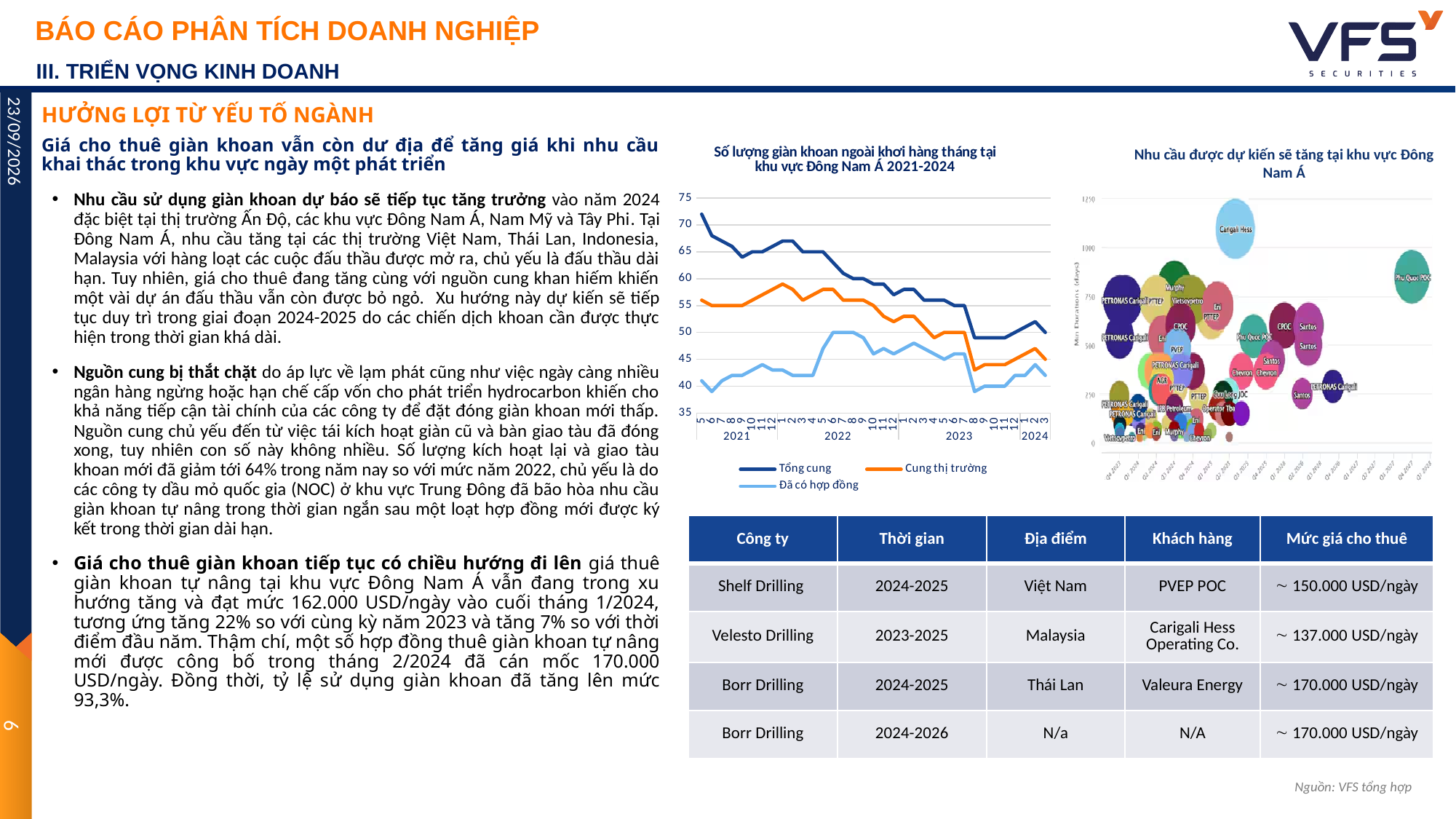
In the chart 'Số lượng giàn khoan ngoài khơi hàng tháng tại khu vực Đông Nam Á 2021-2024', which is larger at month 1 of 2022: 'Cung thị trường' or 'Đã có hợp đồng'? Cung thị trường What is the highest value shown on the vertical axis of the chart 'Số lượng giàn khoan ngoài khơi hàng tháng tại khu vực Đông Nam Á 2021-2024'? 75 In the chart 'Số lượng giàn khoan ngoài khơi hàng tháng tại khu vực Đông Nam Á 2021-2024', does the 'Tổng cung' series rise or fall from 2021 to 2024? fall In the chart 'Số lượng giàn khoan ngoài khơi hàng tháng tại khu vực Đông Nam Á 2021-2024', is the value of 'Đã có hợp đồng' at month 5 of 2021 greater or less than 45? less In the chart 'Số lượng giàn khoan ngoài khơi hàng tháng tại khu vực Đông Nam Á 2021-2024', which series has the lowest values throughout the period? Đã có hợp đồng In the chart 'Số lượng giàn khoan ngoài khơi hàng tháng tại khu vực Đông Nam Á 2021-2024', is the value of 'Tổng cung' at month 3 of 2024 greater or less than 55? less What kind of chart is 'Nhu cầu được dự kiến sẽ tăng tại khu vực Đông Nam Á'? bubble chart In the chart 'Số lượng giàn khoan ngoài khơi hàng tháng tại khu vực Đông Nam Á 2021-2024', is the value of 'Tổng cung' at month 5 of 2021 greater or less than 65? greater In the chart 'Số lượng giàn khoan ngoài khơi hàng tháng tại khu vực Đông Nam Á 2021-2024', which series is plotted with the orange line? Cung thị trường What kind of chart is 'Số lượng giàn khoan ngoài khơi hàng tháng tại khu vực Đông Nam Á 2021-2024'? line chart How many series does the legend of the chart 'Số lượng giàn khoan ngoài khơi hàng tháng tại khu vực Đông Nam Á 2021-2024' list? 3 In the chart 'Số lượng giàn khoan ngoài khơi hàng tháng tại khu vực Đông Nam Á 2021-2024', which series has the highest values throughout the period? Tổng cung